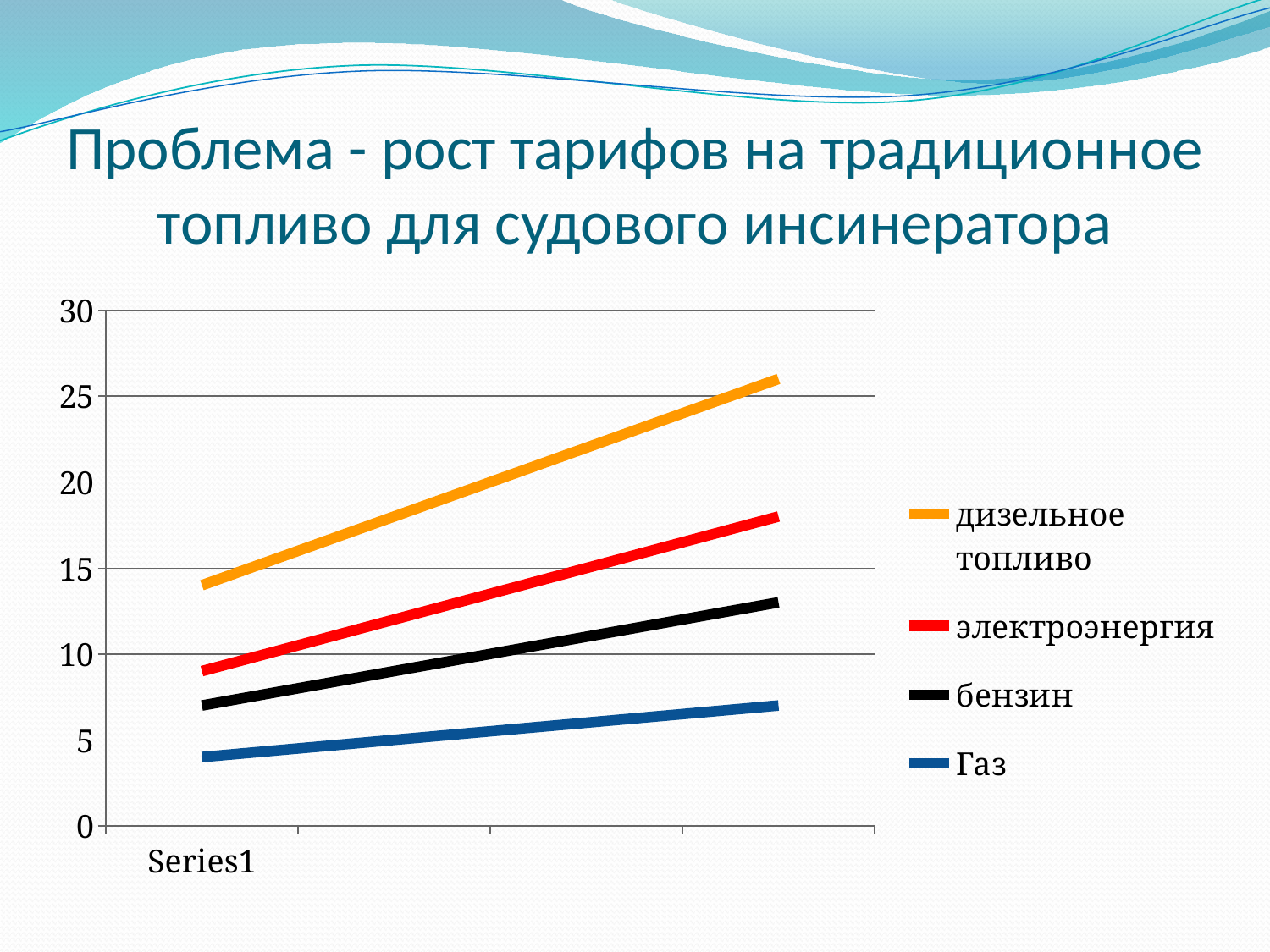
What colour is the line for Газ? blue Which series has the highest values on the chart? дизельное топливо Do the values for дизельное топливо rise or fall along the x axis? rise Is the starting value for Газ greater or less than 5? less Which series has the lowest values on the chart? Газ What kind of chart is shown on the slide? line chart Is the final value for дизельное топливо greater or less than 25? greater Do the values for Газ rise or fall along the x axis? rise Is the starting value for электроэнергия greater or less than 10? less How many series does the legend list? 4 Which series has larger values, электроэнергия or бензин? электроэнергия